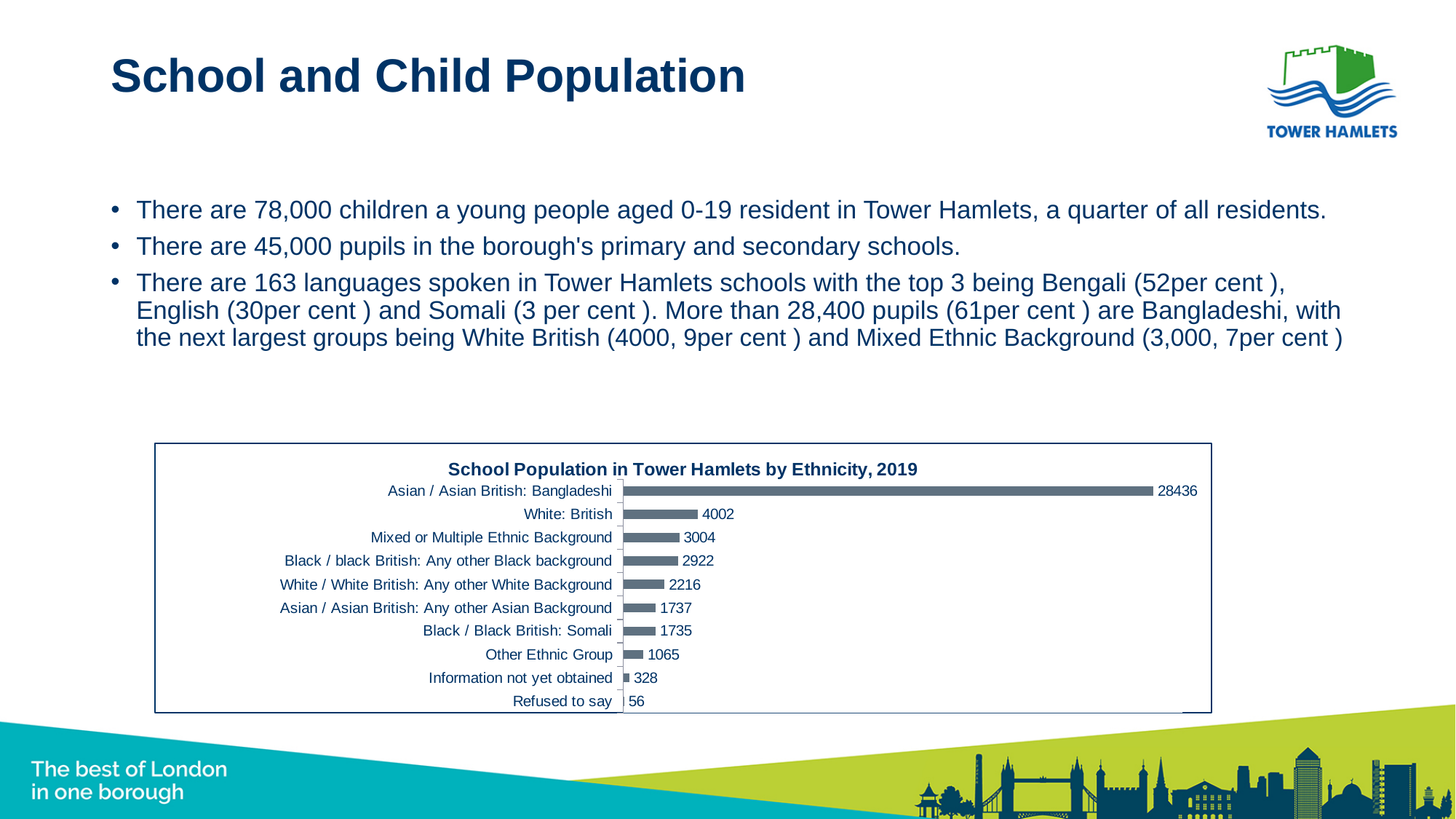
Which is larger: the value for Black / black British: Any other Black background or the value for White / White British: Any other White Background? Black / black British: Any other Black background How many categories are shown in the chart? 10 Which category has the highest value in the chart? Asian / Asian British: Bangladeshi What is the value for Mixed or Multiple Ethnic Background in the chart? 3004 What kind of chart is shown on the slide? Bar chart Which category has the lowest value in the chart? Refused to say What is the difference between the values for Asian / Asian British: Bangladeshi and White: British? 24434 What is the difference between the values for Other Ethnic Group and Information not yet obtained? 737 What is the value for Black / Black British: Somali in the chart? 1735 What is the value for Information not yet obtained in the chart? 328 What is the value for White: British in the chart? 4002 What is the title of the chart on the slide? School Population in Tower Hamlets by Ethnicity, 2019